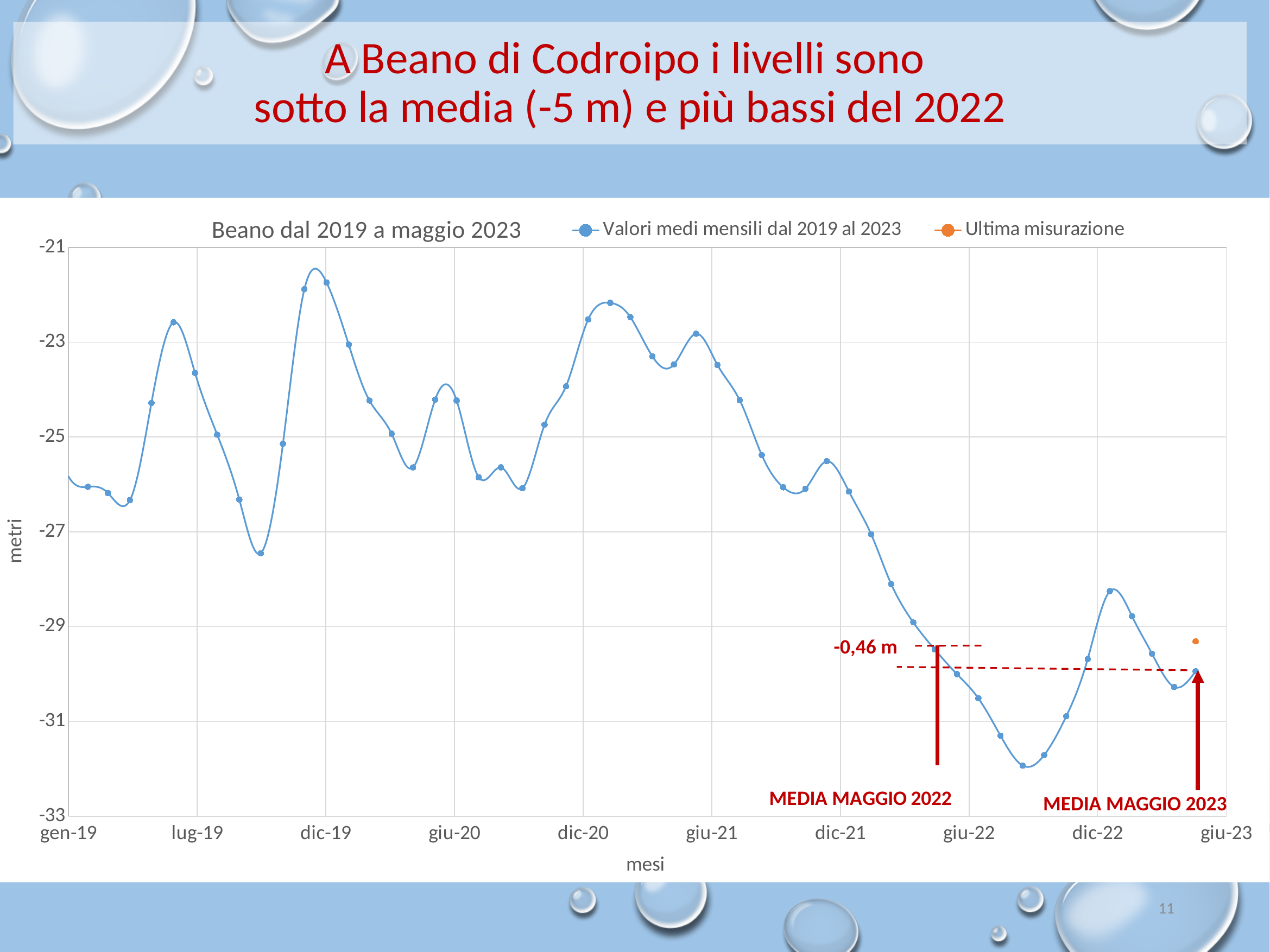
Is the highest point of the monthly average series located near dic-19 or near dic-22? dic-19 Is the monthly average value at dic-22 greater or less than -29? less What kind of chart is shown on the slide? Line chart What label is shown on the vertical axis of the chart? metri What difference in metres is annotated between the May 2022 average and the May 2023 average? -0,46 m Overall, do the monthly average values rise or fall from gen-19 to giu-23? Fall Which is larger, the monthly average value at giu-20 or at giu-22? giu-20 Is the monthly average value at dic-19 greater or less than -23? greater Is the lowest point of the monthly average series located before or after giu-22? After How many series does the chart legend list? 2 What is the title of the chart? Beano dal 2019 a maggio 2023 Is the monthly average value at gen-19 greater or less than -25? less